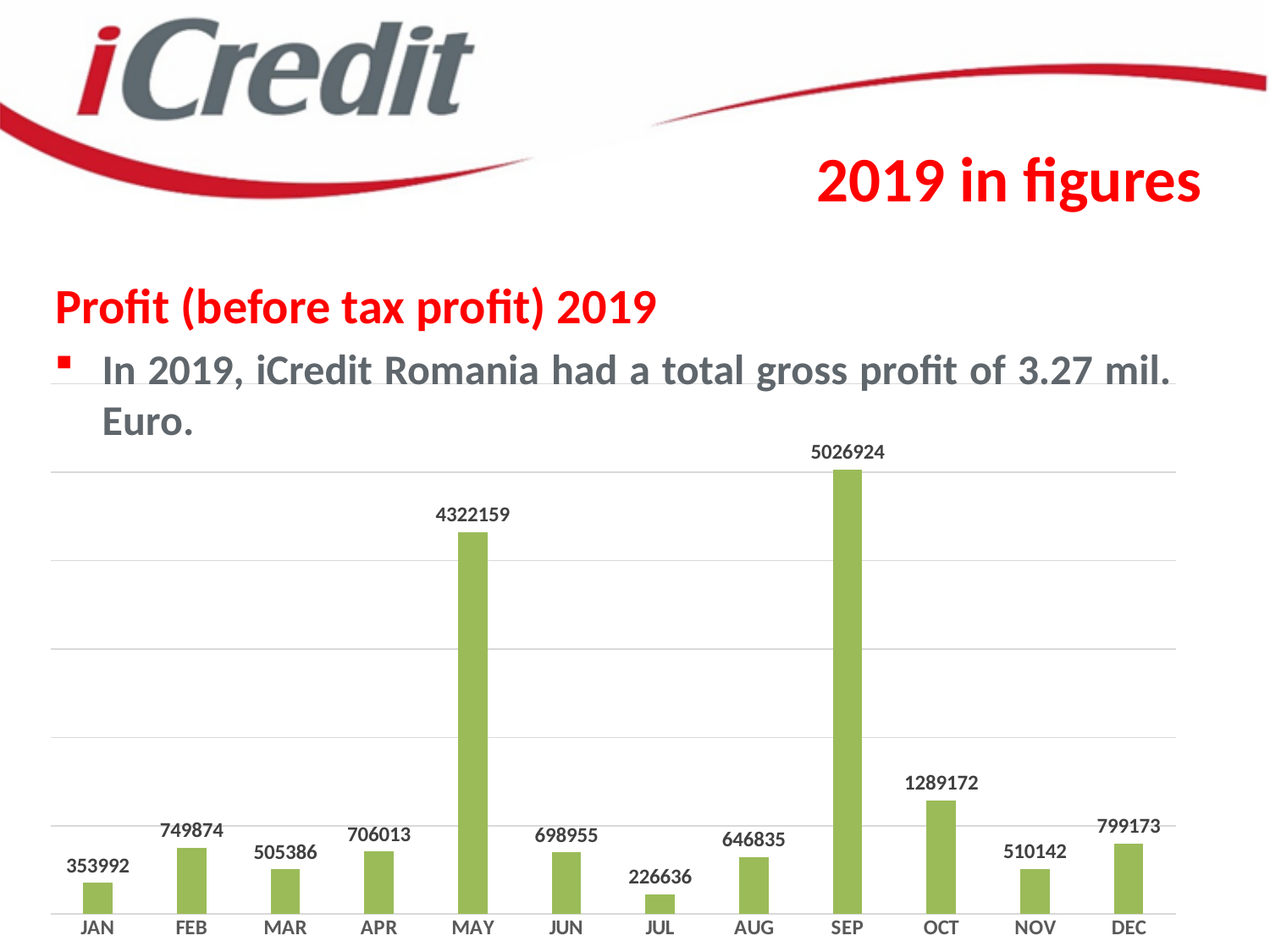
Which month has the lowest profit in the chart? JUL What type of chart is shown on the slide? Bar chart Which is larger, the value for FEB or the value for MAR? FEB What is the profit value shown for SEP? 5026924 What colour are the bars in the chart? Green What is the profit value shown for MAY? 4322159 How many months are plotted in the chart? 12 What is the profit value shown for JUL? 226636 What is the difference between the OCT and DEC values? 489999 What is the difference between the SEP and MAY values? 704765 Which month has the highest profit in the chart? SEP What is the profit value shown for OCT? 1289172